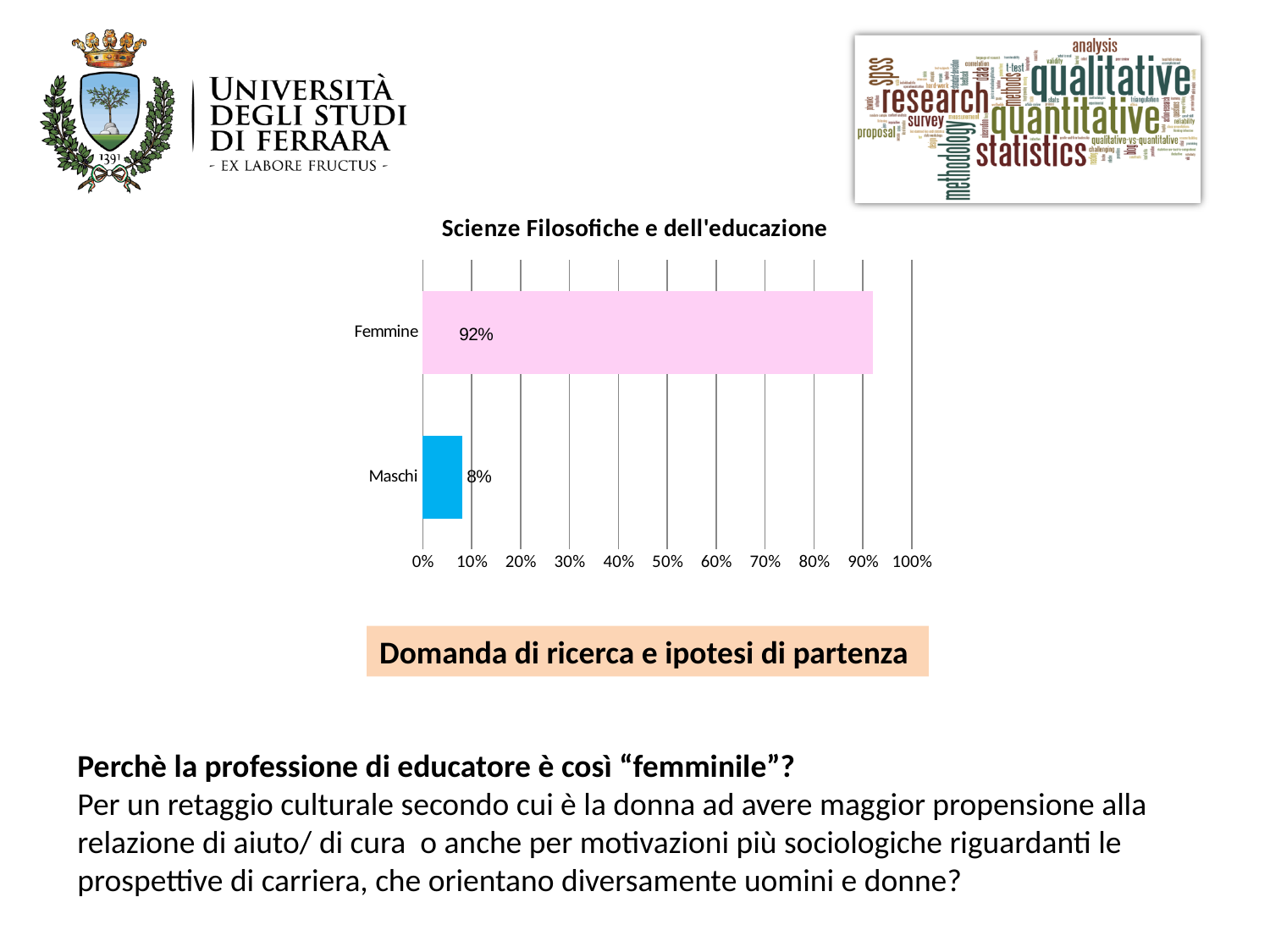
How many categories are shown in the chart? 2 What is the value for Maschi? 8% What is the difference between the values for Femmine and Maschi? 84% Which category has the lowest value? Maschi What is the value for Femmine? 92% Which category has the highest value? Femmine Is the value for Maschi greater or less than 10%? less Is the value for Femmine greater or less than 90%? greater What is the title of the chart? Scienze Filosofiche e dell'educazione Which is larger, the value for Femmine or the value for Maschi? Femmine What kind of chart is shown on the slide? bar chart What colour is the bar for Femmine? pink